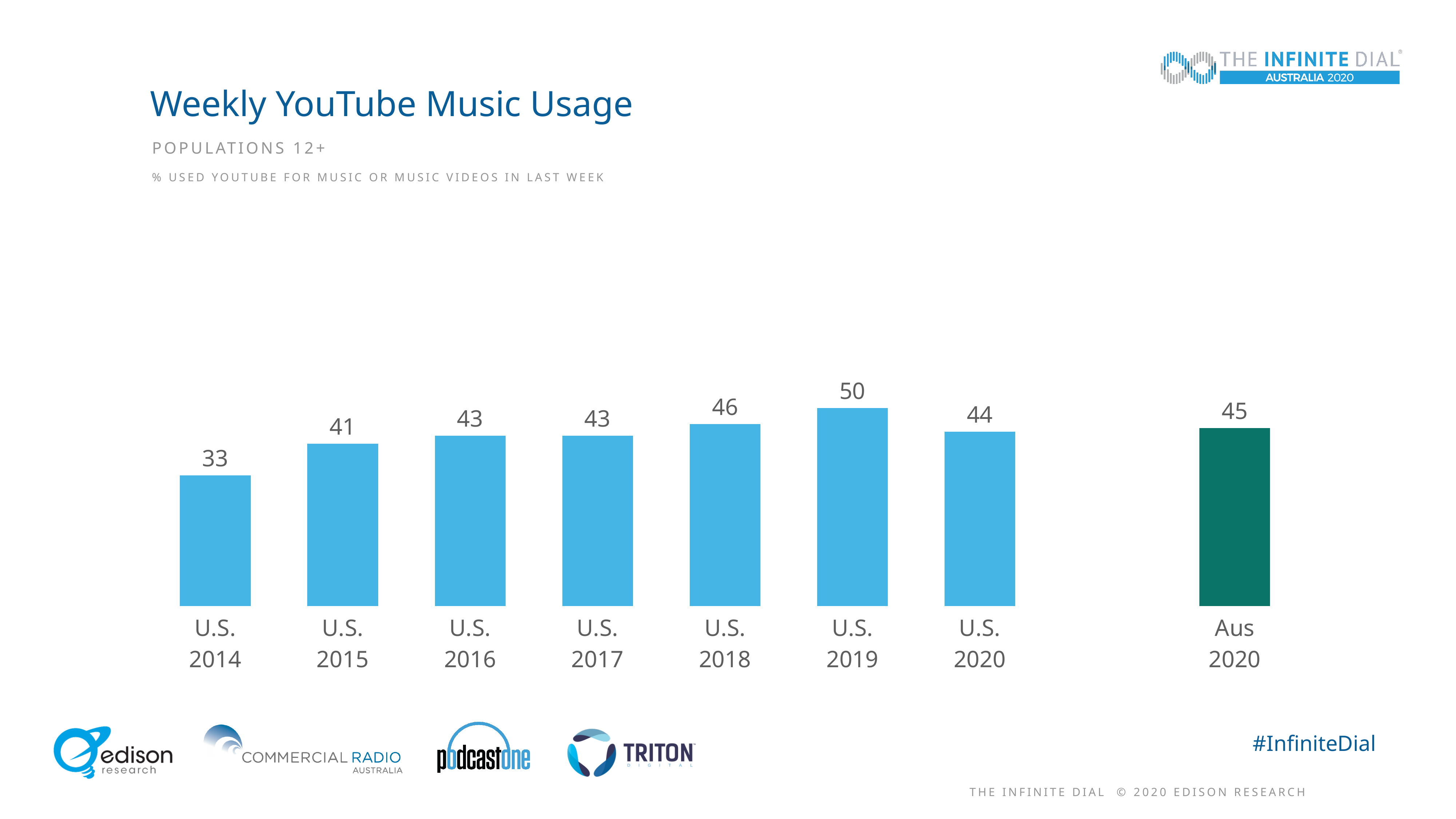
Which category has the lowest value? U.S. 2014 What kind of chart is shown on the slide? Bar chart What is the difference between the values for U.S. 2019 and U.S. 2020? 6 Which is larger, the value for U.S. 2020 or Aus 2020? Aus 2020 What is the difference between the values for Aus 2020 and U.S. 2014? 12 What is the value for U.S. 2014? 33 Which category has the highest value? U.S. 2019 Do the U.S. values rise or fall from 2014 to 2019? Rise What is the value for Aus 2020? 45 How many bars are shown in the chart? 8 What is the value for U.S. 2018? 46 What is the title of the chart? Weekly YouTube Music Usage